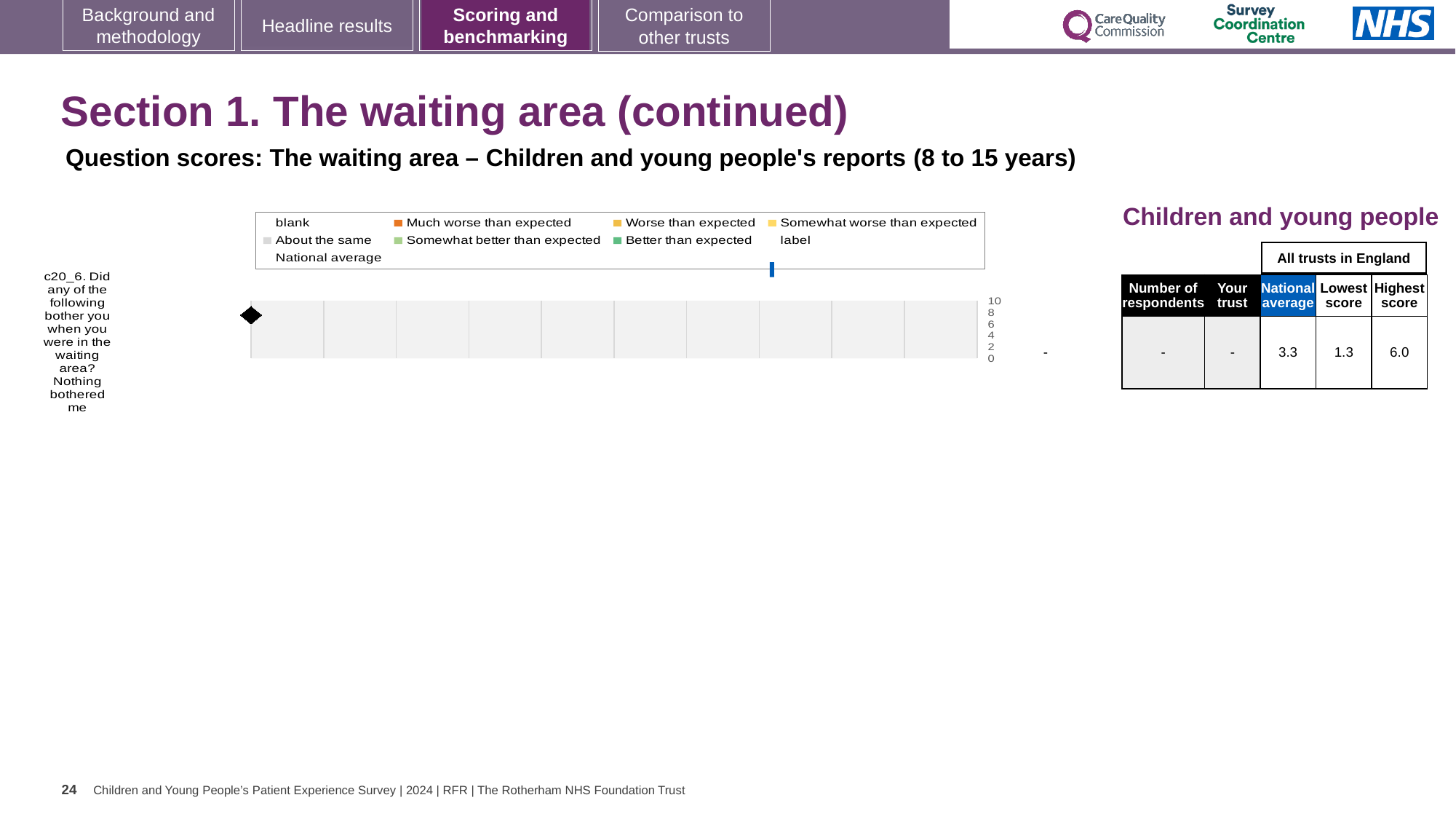
What is the national average score for question c20_6 shown in the table next to the chart? 3.3 Is the national average score for question c20_6 greater or less than 4? less What kind of chart is shown on the slide? bar chart What is the highest score across all trusts in England for question c20_6? 6.0 What colour does the legend use for 'Much worse than expected'? orange What is the lowest score across all trusts in England for question c20_6? 1.3 Which is larger for question c20_6: the national average or the highest score? Highest score What is the highest value shown on the chart's axis? 10 How many question categories are plotted on the chart? 1 What is the difference between the highest score and the lowest score for question c20_6? 4.7 What value is shown for 'Your trust' for question c20_6? -